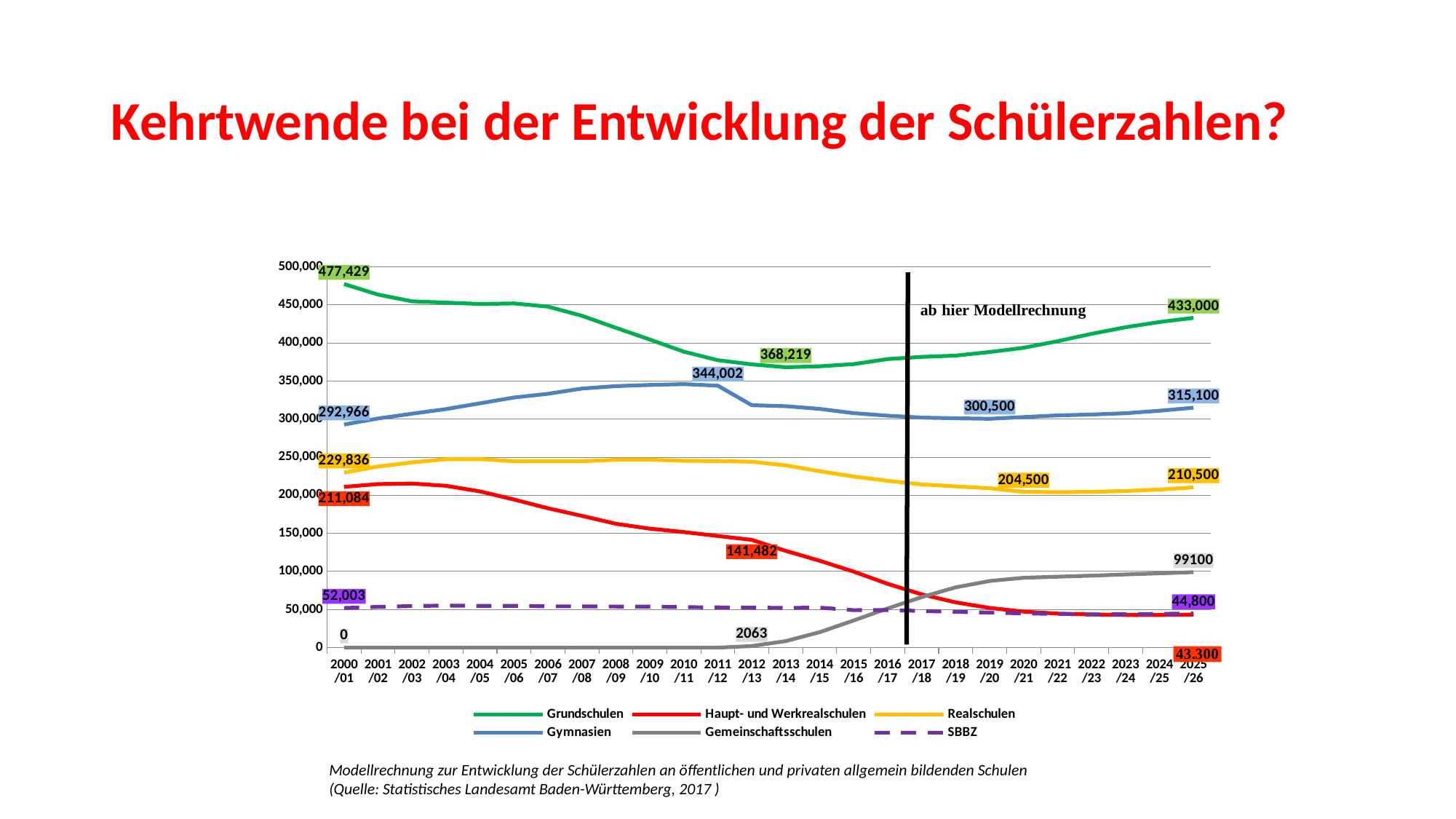
Is the value for Realschulen in 2010/11 greater or less than 200,000? greater Which series has the lowest value in 2000/01? Gemeinschaftsschulen What is the value for Gymnasien in 2025/26? 315,100 In 2025/26, which is larger: Gemeinschaftsschulen or SBBZ? Gemeinschaftsschulen How many series does the legend list? 6 Do the values for Haupt- und Werkrealschulen rise or fall from 2000/01 to 2025/26? fall What is the value for Gemeinschaftsschulen in 2025/26? 99100 Which series has the highest value in 2000/01? Grundschulen What is the value for Grundschulen in 2000/01? 477,429 What is the difference between the Haupt- und Werkrealschulen value in 2000/01 and in 2025/26? 167,784 What kind of chart is shown on the slide? line chart What is the difference between the Grundschulen value in 2000/01 and in 2025/26? 44,429